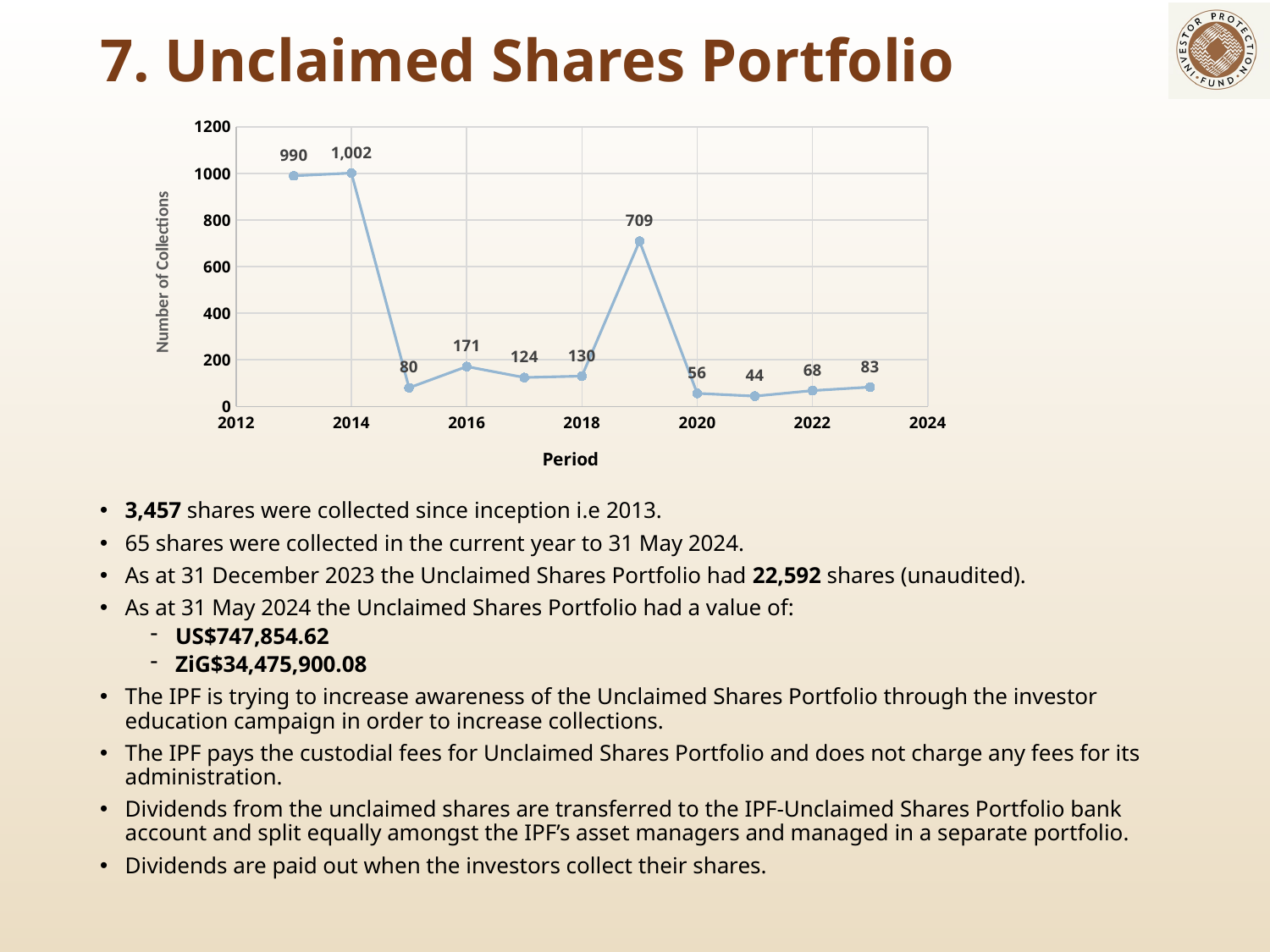
Which year has the highest number of collections? 2014 How many data points are plotted on the chart? 11 What is the number of collections for 2022? 68 Which year has more collections, 2016 or 2018? 2016 What is the difference in collections between 2014 and 2020? 946 What is the number of collections for 2014? 1,002 What kind of chart is shown on the slide? Line chart Which year has the lowest number of collections? 2021 What is the number of collections for 2016? 171 What is the label of the y axis? Number of Collections What is the number of collections for 2020? 56 What is the number of collections for 2018? 130